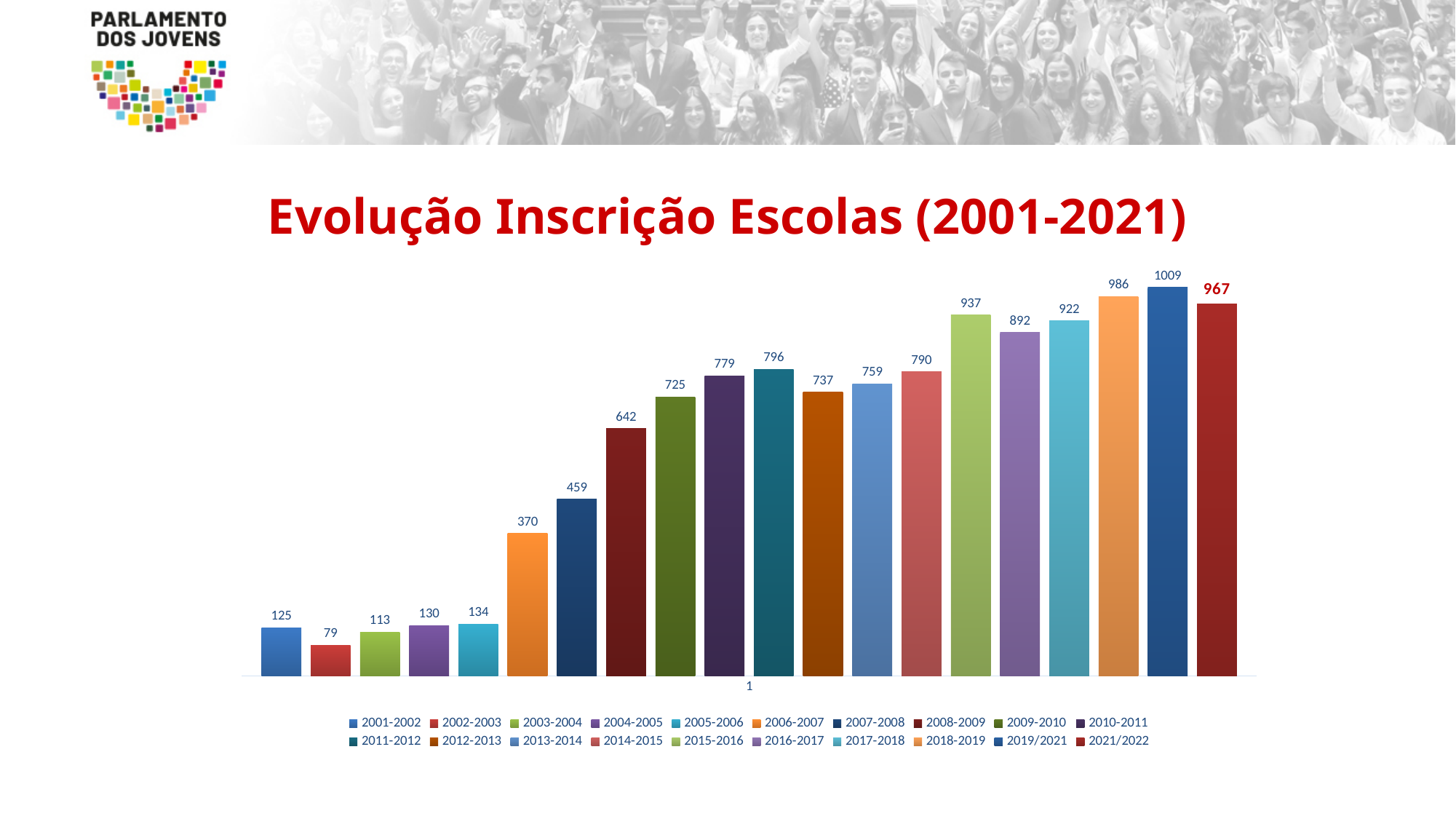
How many bars are plotted on the chart? 20 What is the difference between the values for 2007-2008 and 2006-2007? 89 What is the value for 2012-2013? 737 How many series does the legend list? 20 What is the value for 2021/2022? 967 What is the difference between the values for 2019/2021 and 2021/2022? 42 What kind of chart is shown on the slide? Bar chart What is the value for 2006-2007? 370 Which series has the lowest value? 2002-2003 Which is larger, the value for 2015-2016 or the value for 2016-2017? 2015-2016 Which series has the highest value? 2019/2021 What is the value for 2019/2021? 1009